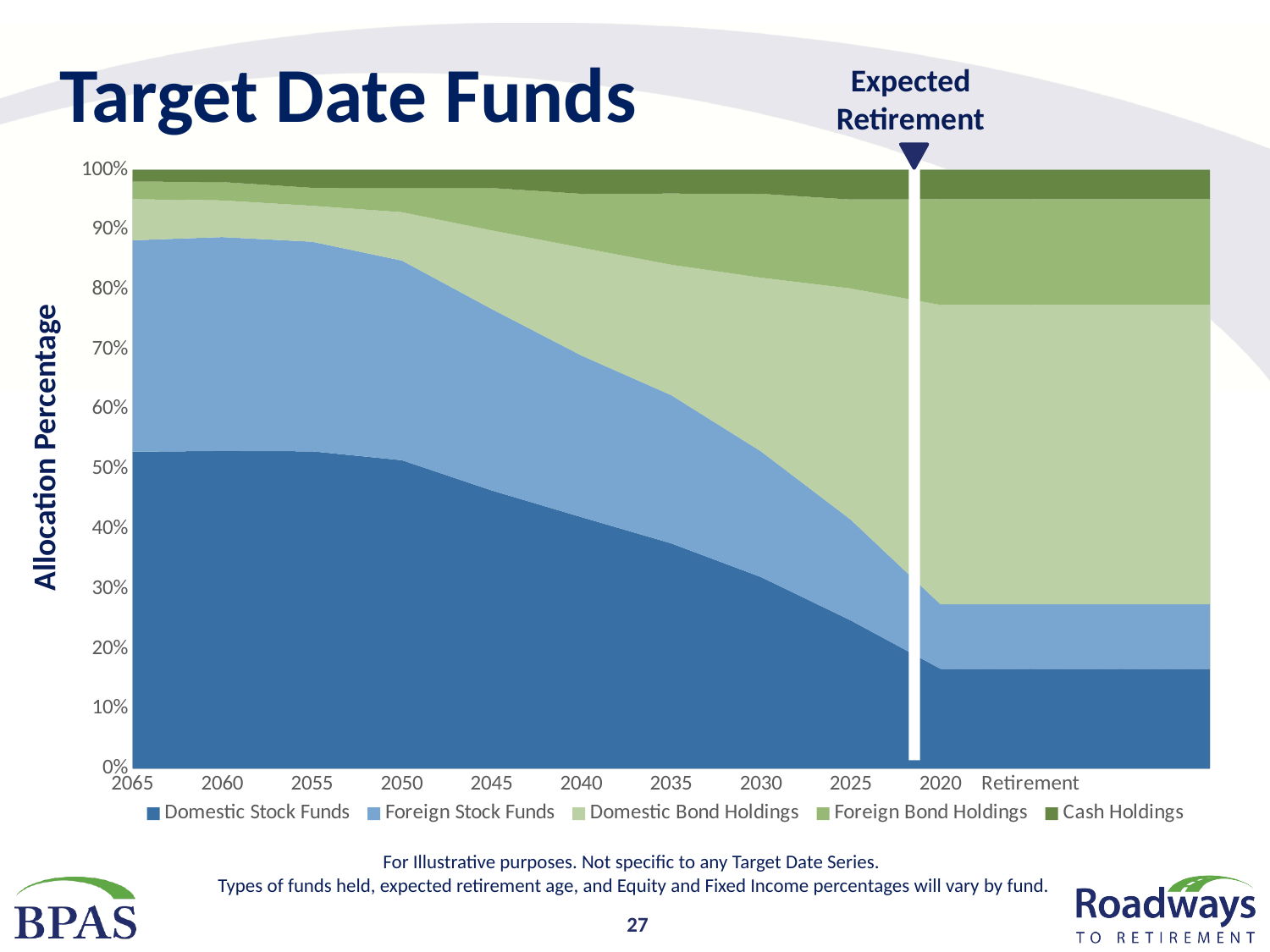
Which series has the smallest allocation at 2065? Cash Holdings Which series has the largest allocation at 2065? Domestic Stock Funds What is the label on the y axis? Allocation Percentage How many labels are shown along the x axis? 11 How many series does the legend list? 5 Is the allocation to Domestic Stock Funds at 2065 greater or less than 40%? greater Is the allocation to Domestic Stock Funds at Retirement greater or less than 20%? less At Retirement, which is larger: the allocation to Domestic Bond Holdings or to Domestic Stock Funds? Domestic Bond Holdings Does the allocation to Domestic Bond Holdings rise or fall as the x axis moves from 2065 toward Retirement? Rise What is the title of the chart? Target Date Funds What kind of chart is shown on the slide? Stacked area chart Does the allocation to Domestic Stock Funds rise or fall as the x axis moves from 2065 toward Retirement? Fall